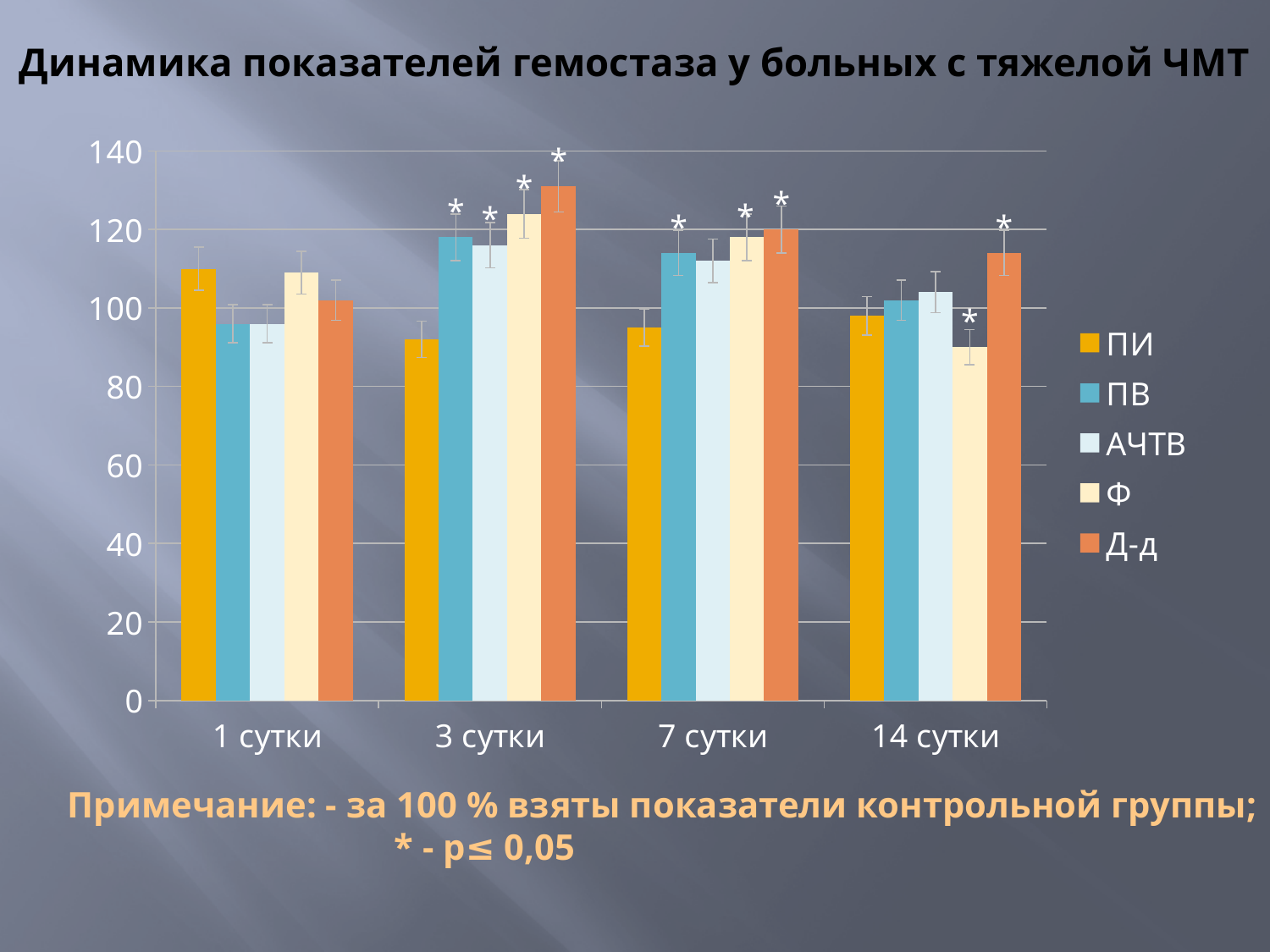
In which category does the Д-д series reach its highest value? 3 сутки Is the value for Д-д at 3 сутки greater or less than 120? greater How many series does the legend list? 5 Does the value for Д-д rise or fall from 1 сутки to 3 сутки? rise How many time-point categories are shown on the x axis? 4 Is the value for Ф at 14 сутки greater or less than 100? less Is the value for ПИ at 3 сутки greater or less than 100? less What is the title of the chart on the slide? Динамика показателей гемостаза у больных с тяжелой ЧМТ Which series has the lowest value at 14 сутки? Ф At 1 сутки, which is larger: ПИ or ПВ? ПИ Which series has the highest value at 3 сутки? Д-д What kind of chart is shown on the slide? bar chart